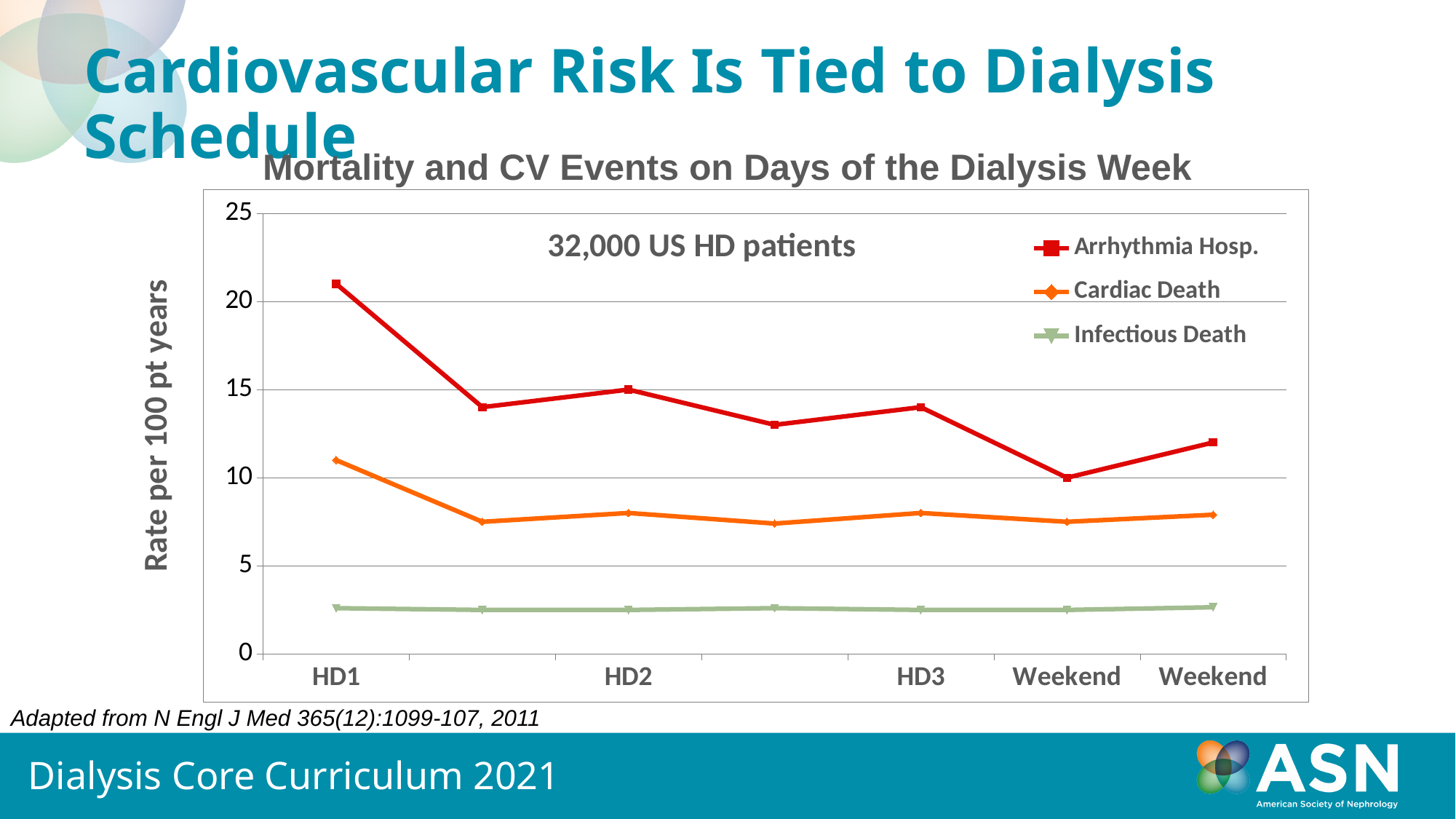
What is the title of the chart? Mortality and CV Events on Days of the Dialysis Week Is the Infectious Death value at HD1 greater or less than 5? less Is the Arrhythmia Hosp. value at HD1 greater or less than 20? greater Is the Cardiac Death value at HD1 greater or less than 10? greater What is the label on the y axis of the chart? Rate per 100 pt years Which series has the lowest values across the whole chart? Infectious Death At HD3, which is larger: Cardiac Death or Infectious Death? Cardiac Death At which labeled day is the Arrhythmia Hosp. value highest? HD1 Which series has the highest value at HD1? Arrhythmia Hosp. What kind of chart is shown on the slide? line chart How many series does the legend list? 3 Does the Arrhythmia Hosp. line rise or fall from HD1 to HD2? fall